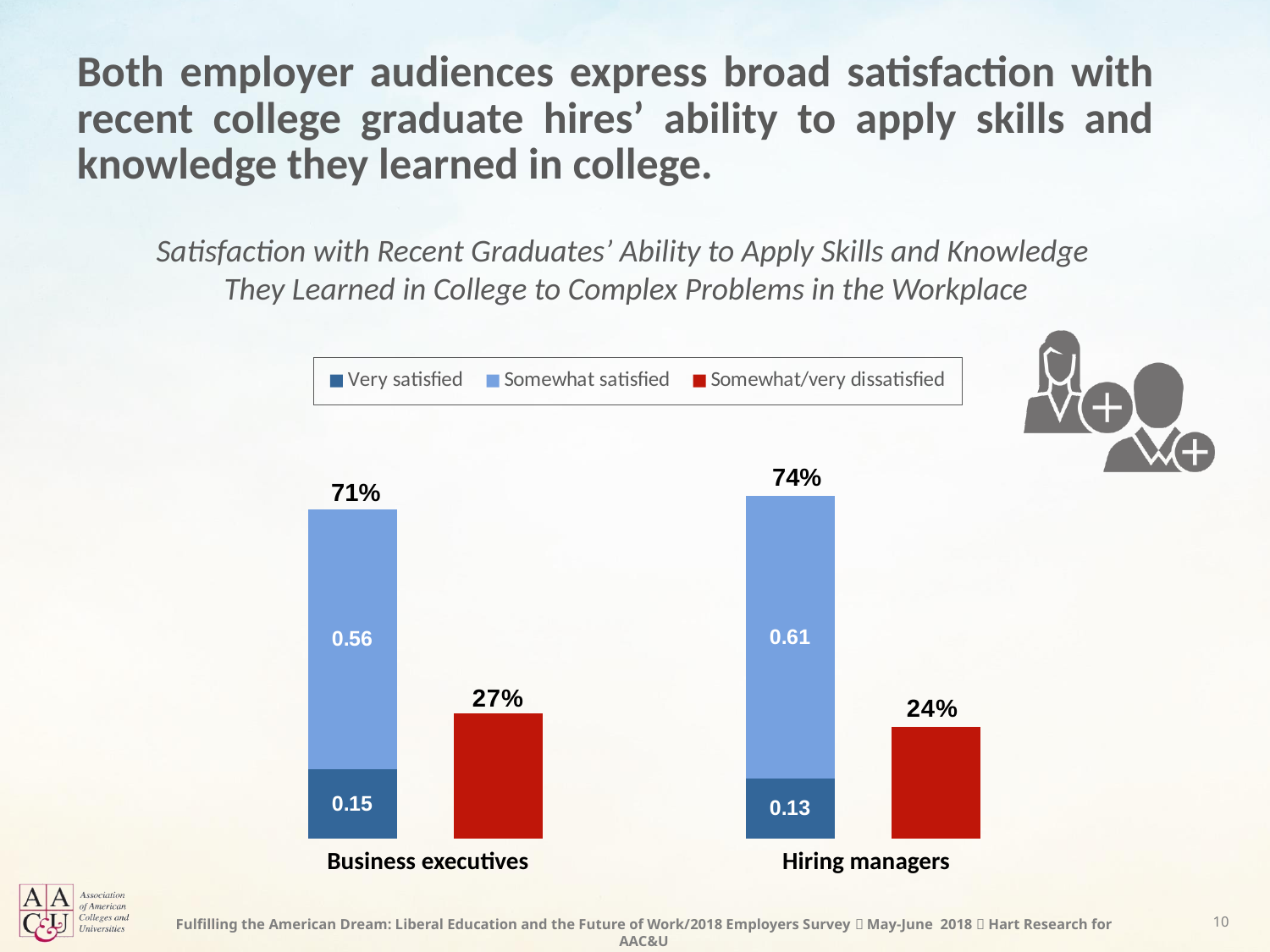
What kind of chart is shown on the slide? Stacked bar chart What is the difference between the Somewhat/very dissatisfied percentages for Business executives and Hiring managers? 3% Which group has the higher Very satisfied value? Business executives What is the value for Somewhat satisfied among Hiring managers? 0.61 What is the total satisfied (Very satisfied plus Somewhat satisfied) share shown above the stacked bar for Business executives? 71% What is the value for Very satisfied among Business executives? 0.15 How many employer groups (categories) are shown on the x axis? 2 What is the difference between the Somewhat satisfied values for Hiring managers and Business executives? 0.05 Which group has the higher Somewhat/very dissatisfied percentage, Business executives or Hiring managers? Business executives What is the total satisfied share shown above the stacked bar for Hiring managers? 74% How many series does the legend list? 3 What percentage of Hiring managers are Somewhat/very dissatisfied? 24%